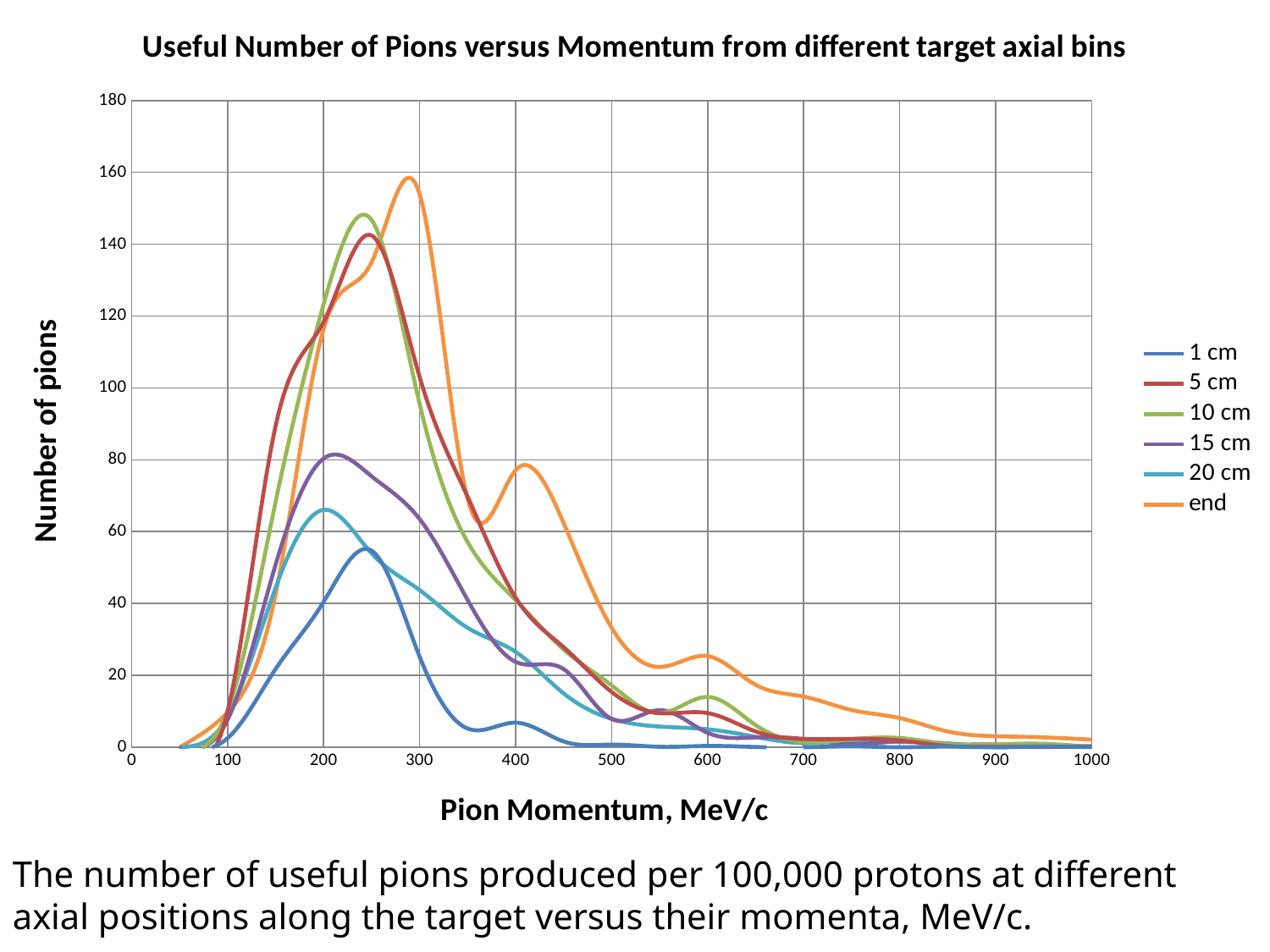
What is the label of the x axis? Pion Momentum, MeV/c How many series does the legend list? 6 Is the peak value of the "20 cm" series greater or less than 80? less Is the peak value of the "end" series greater or less than 140? greater Which series has the larger peak: "5 cm" or "15 cm"? 5 cm Do the values of the "10 cm" series rise or fall as momentum increases from 300 to 600 MeV/c? fall Which series has the lowest peak number of pions? 1 cm Which series reaches the highest peak number of pions? end What kind of chart is shown on the slide? line chart Is the peak value of the "15 cm" series greater or less than 100? less At a pion momentum of 400 MeV/c, which series is higher: "end" or "5 cm"? end